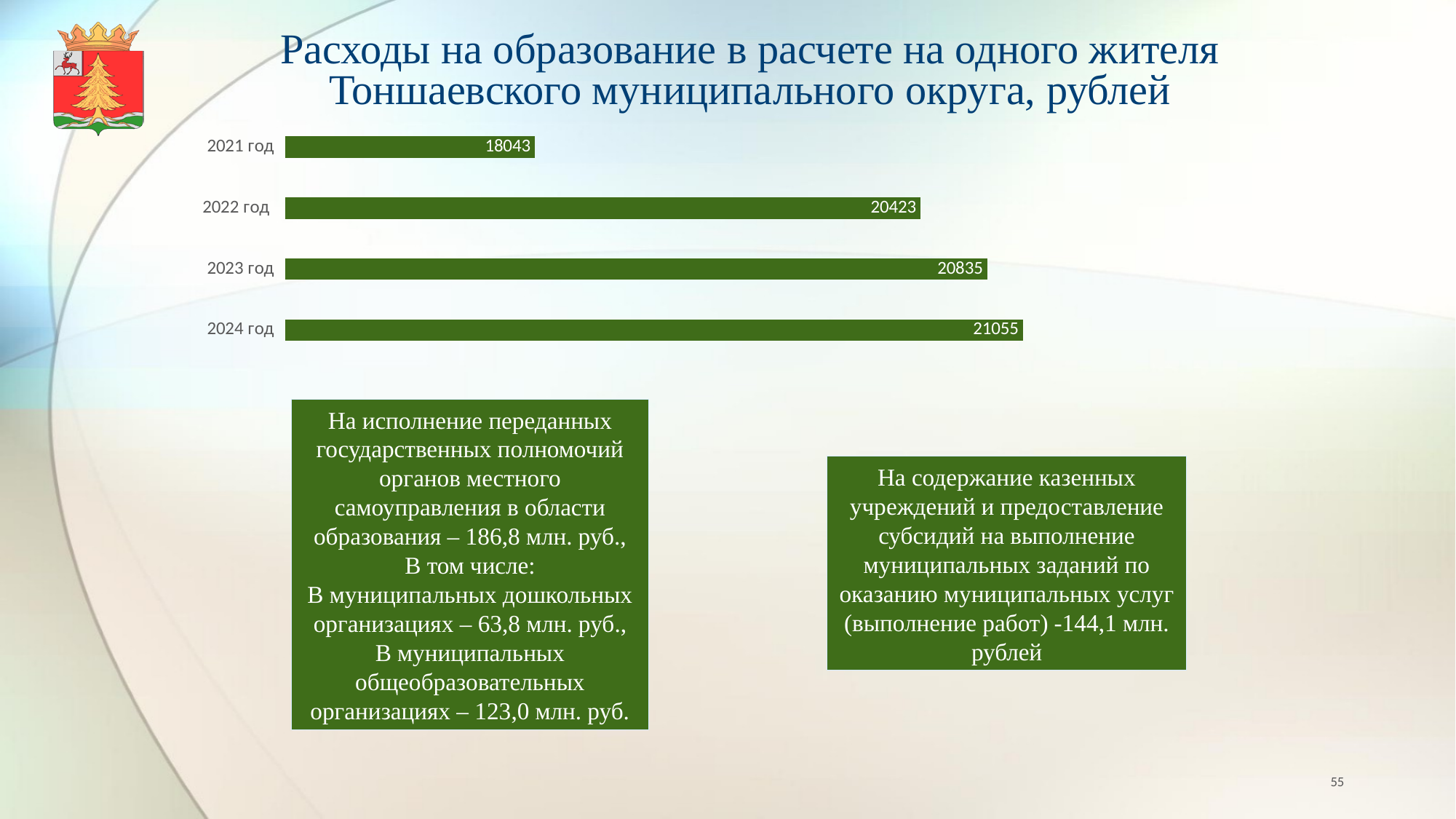
What kind of chart is shown on the slide? bar chart Which year has the highest value? 2024 год Which is larger, the value for 2022 год or the value for 2021 год? 2022 год What is the value for 2024 год? 21055 What is the value for 2021 год? 18043 What is the value for 2022 год? 20423 What is the value for 2023 год? 20835 What is the difference between the values for 2024 год and 2021 год? 3012 How many years are shown in the chart? 4 What is the difference between the values for 2023 год and 2022 год? 412 Do the values rise or fall from 2021 год to 2024 год? rise Which year has the lowest value? 2021 год